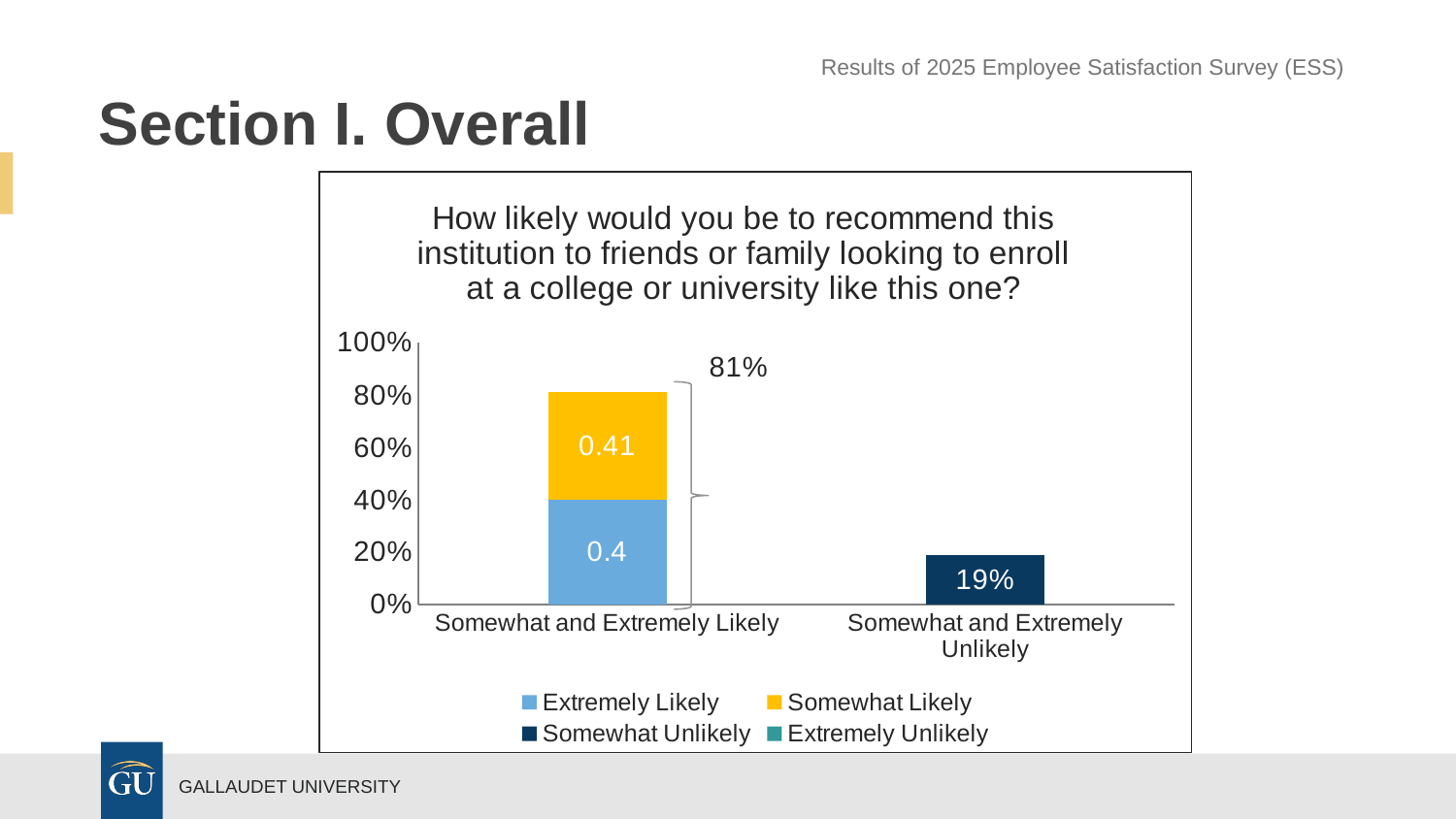
Which category has the taller bar, Somewhat and Extremely Likely or Somewhat and Extremely Unlikely? Somewhat and Extremely Likely How many categories are shown on the x axis of the chart? 2 What value is labelled on the Somewhat and Extremely Unlikely bar? 19% What is the value labelled for Extremely Likely in the Somewhat and Extremely Likely bar? 0.4 How many series does the chart's legend list? 4 What is the total shown for the Somewhat and Extremely Likely stacked bar? 81% What kind of chart is shown on the slide? Stacked bar chart Is the value for Somewhat and Extremely Unlikely greater or less than 40%? less What is the value labelled for Somewhat Likely in the Somewhat and Extremely Likely bar? 0.41 What colour is the Somewhat Likely segment in the chart? Yellow What is the difference between the Somewhat Likely value (0.41) and the Extremely Likely value (0.4)? 0.01 Which category has the highest total value? Somewhat and Extremely Likely